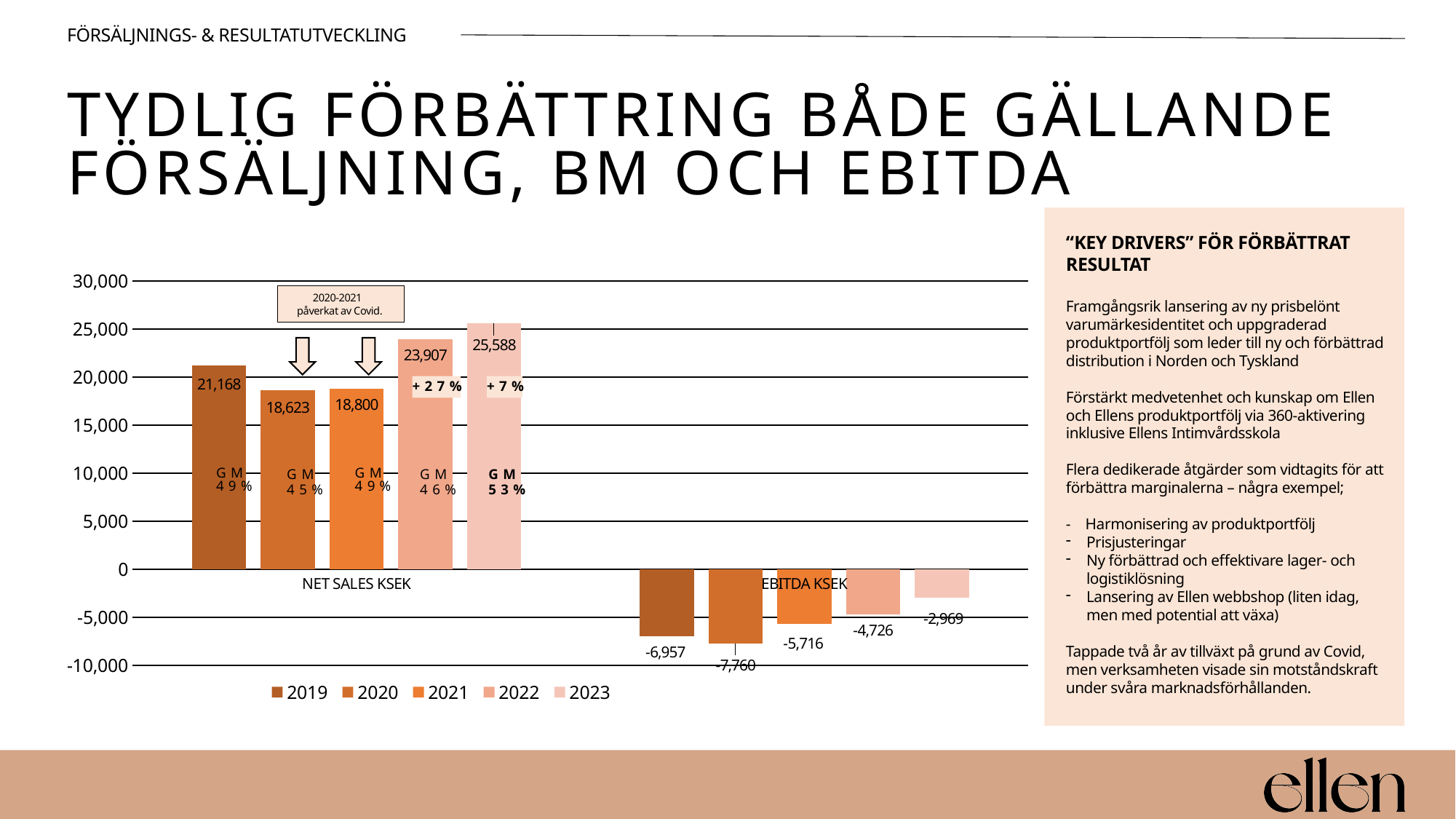
Which year has the highest NET SALES KSEK? 2023 What is the NET SALES KSEK value for 2023? 25,588 What is the NET SALES KSEK value for 2021? 18,800 Which year has the lowest (most negative) EBITDA KSEK? 2020 Do the EBITDA KSEK values rise or fall from 2021 to 2023? Rise What is the difference between NET SALES KSEK in 2023 and 2022? 1,681 What is the EBITDA KSEK value for 2020? -7,760 Which is larger, NET SALES KSEK in 2019 or in 2021? 2019 How many series does the legend list? 5 Which year has the lowest NET SALES KSEK? 2020 What gross margin (GM) percentage is shown on the 2023 NET SALES bar? 53 % What kind of chart is shown on the slide? Bar chart